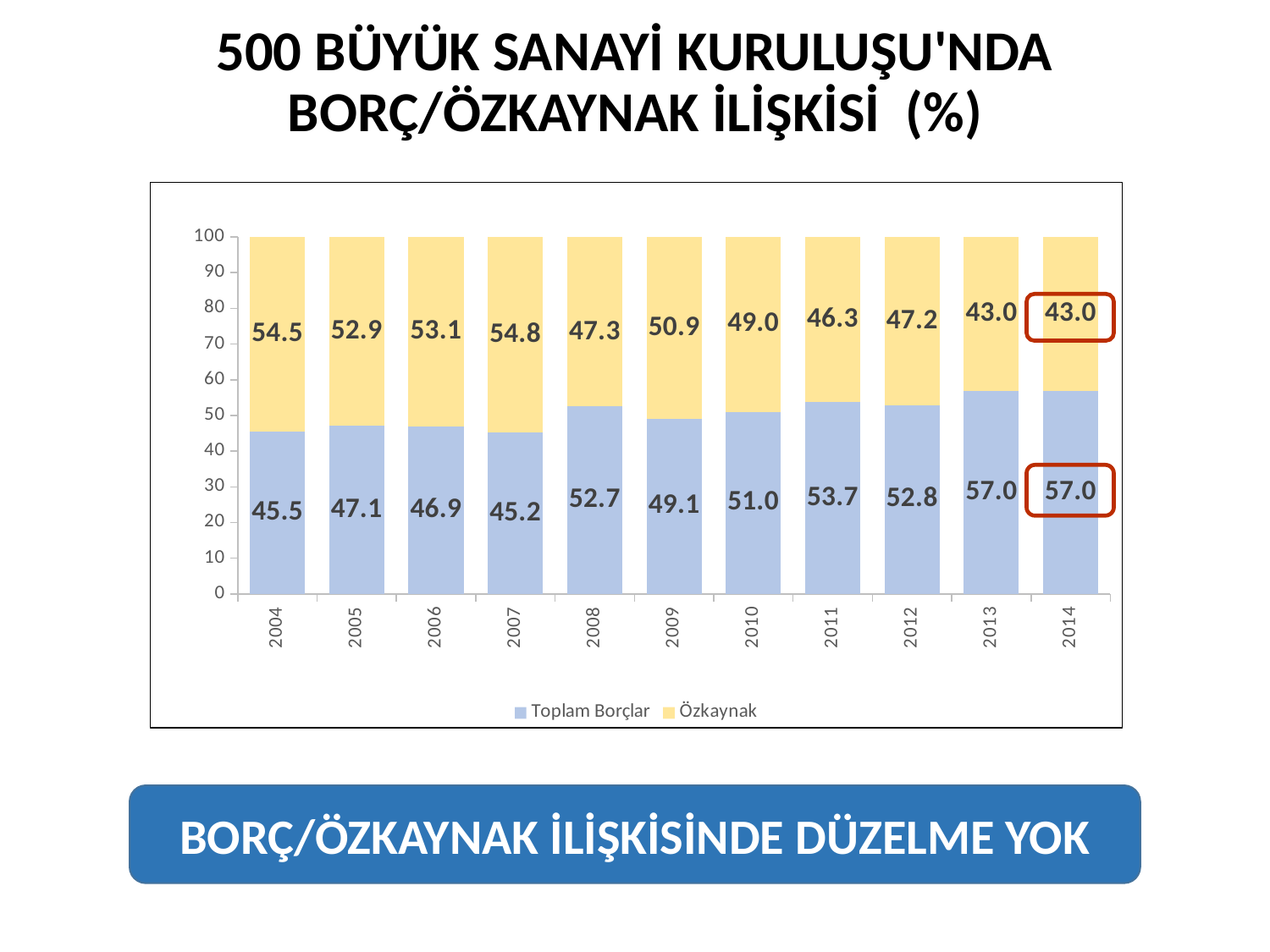
What is the difference between the Toplam Borçlar values for 2014 and 2004? 11.5 Which year has the lowest Toplam Borçlar value? 2007 Which year has the highest Toplam Borçlar value? 2013 and 2014 (57.0) Which year has the lowest Özkaynak value? 2013 and 2014 (43.0) Which is larger, the Özkaynak value for 2005 or for 2010? 2005 How many years are shown on the x axis? 11 What kind of chart is shown on the slide? Stacked bar chart What is the total of the stacked bar for 2011? 100 How many series does the legend list? 2 Which series is shown in yellow? Özkaynak What is the Özkaynak value for 2009? 50.9 What is the Toplam Borçlar value for 2008? 52.7